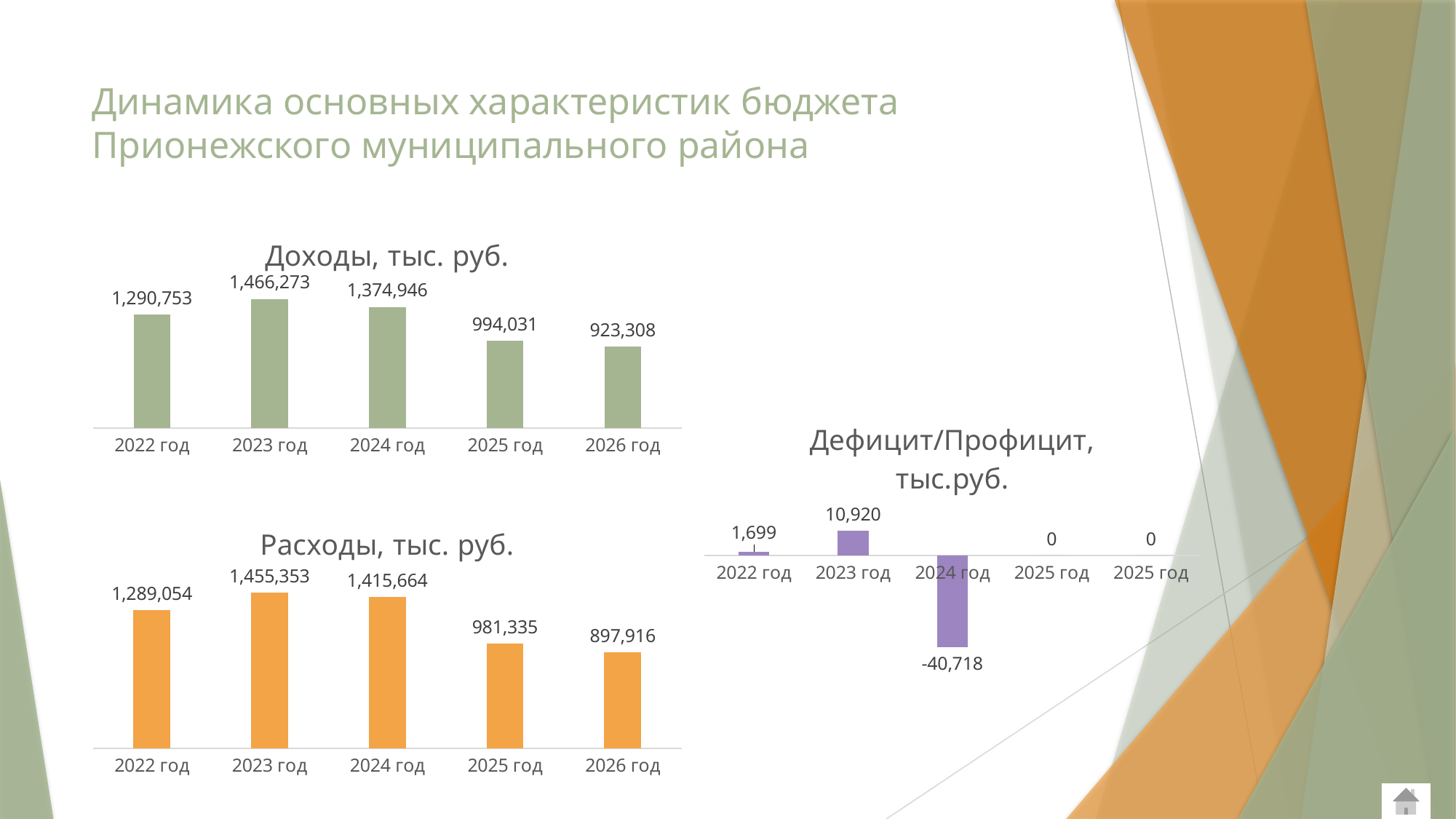
In the chart titled "Доходы, тыс. руб.", what is the value for 2023 год? 1,466,273 In the chart titled "Дефицит/Профицит, тыс.руб.", which year has the highest value? 2023 год In the chart titled "Расходы, тыс. руб.", which year has the highest value? 2023 год In the chart titled "Доходы, тыс. руб.", is the value for 2024 год larger or smaller than the value for 2025 год? Larger In the chart titled "Расходы, тыс. руб.", how many years are shown? 5 What kind of chart is the one titled "Доходы, тыс. руб."? Bar chart In the chart titled "Дефицит/Профицит, тыс.руб.", what is the value for 2022 год? 1,699 In the chart titled "Расходы, тыс. руб.", what is the difference between the values for 2023 год and 2024 год? 39,689 In the chart titled "Доходы, тыс. руб.", what is the difference between the values for 2023 год and 2022 год? 175,520 In the chart titled "Расходы, тыс. руб.", what is the value for 2025 год? 981,335 In the chart titled "Дефицит/Профицит, тыс.руб.", what is the value for 2024 год? -40,718 In the chart titled "Доходы, тыс. руб.", which year has the lowest value? 2026 год